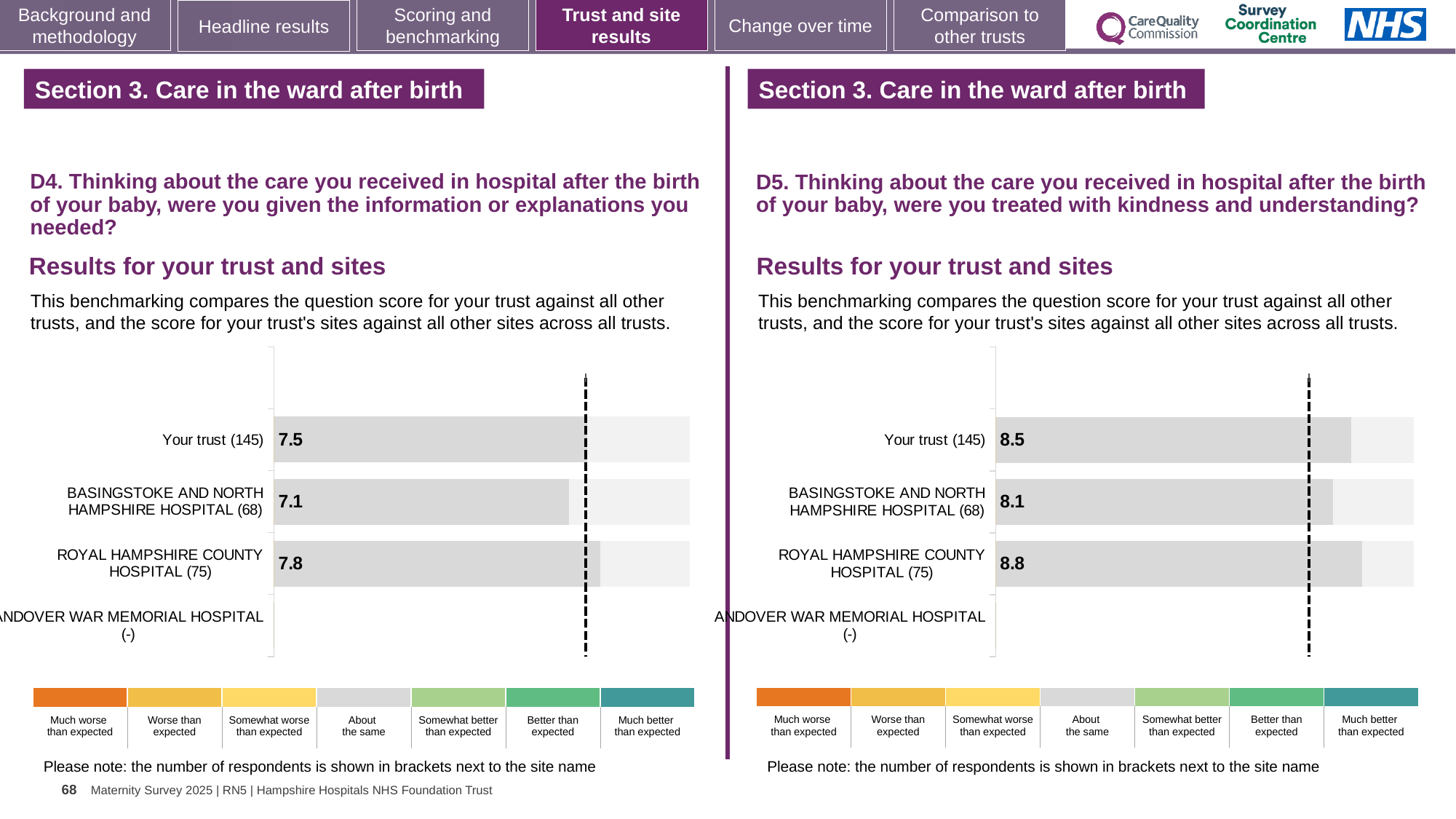
In the D4 chart on the left, what is the difference between the scores for Royal Hampshire County Hospital (75) and Basingstoke and North Hampshire Hospital (68)? 0.7 What kind of chart is used for the D5 results on the right? Bar chart In the D5 chart on the right, which has the larger score: Your trust (145) or Royal Hampshire County Hospital (75)? Royal Hampshire County Hospital (75) In the D4 chart on the left, what is the score for Your trust (145)? 7.5 In the D5 chart on the right, what is the score for Royal Hampshire County Hospital (75)? 8.8 In the D4 chart on the left, which site or trust has the highest score? Royal Hampshire County Hospital (75) In the D5 chart on the right, what is the score for Your trust (145)? 8.5 In the D4 chart on the left, what is the score for Basingstoke and North Hampshire Hospital (68)? 7.1 How many categories are listed on the vertical axis of the D4 chart on the left? 4 In the D5 chart on the right, what is the difference between the scores for Your trust (145) and Basingstoke and North Hampshire Hospital (68)? 0.4 In the D4 chart on the left, which site shows no score, marked with (-)? Andover War Memorial Hospital In the D5 chart on the right, which site or trust has the lowest score? Basingstoke and North Hampshire Hospital (68)